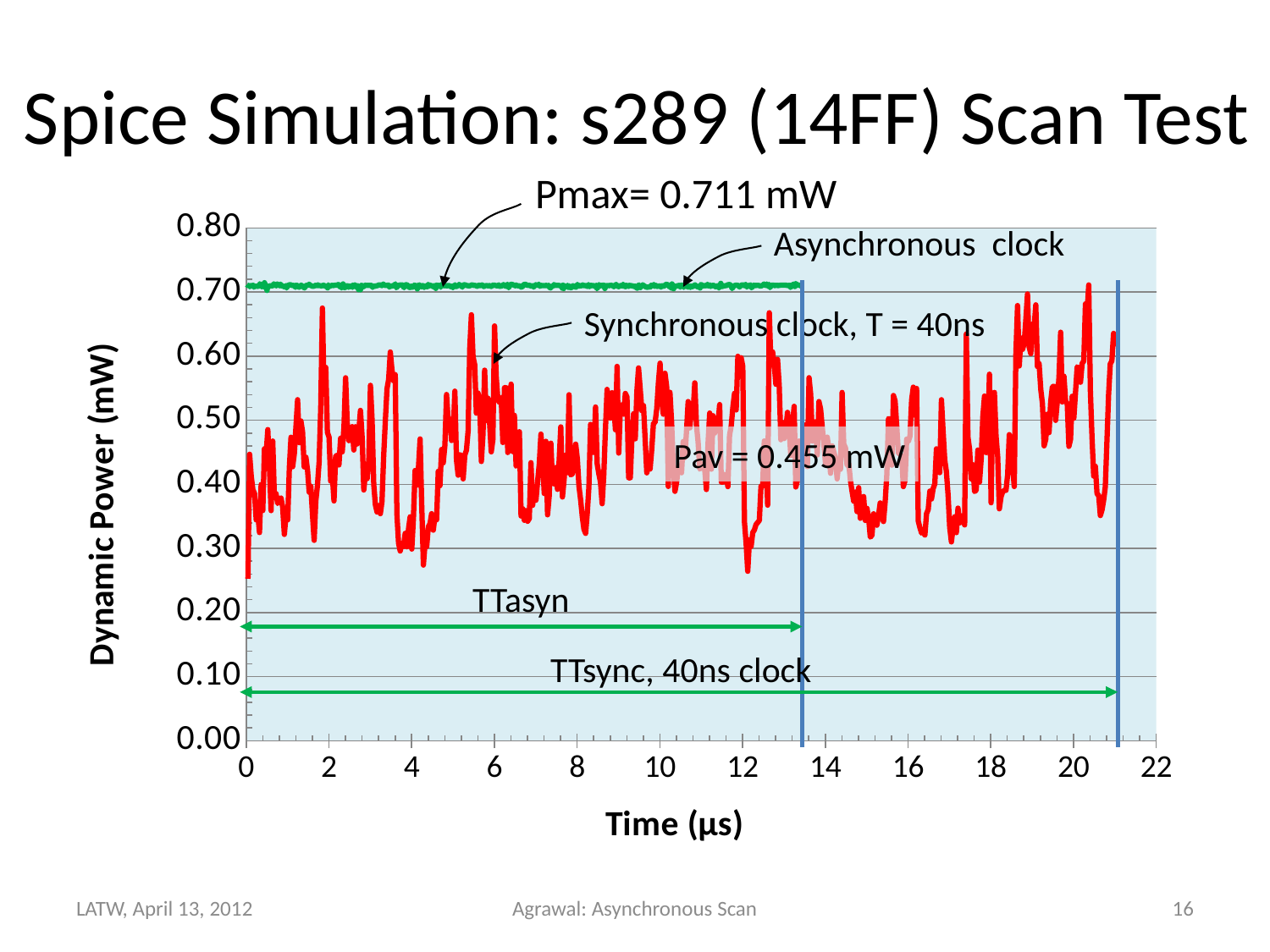
What kind of chart is shown on the slide? line chart What is the value of Pmax annotated on the chart? 0.711 mW Which series has the higher dynamic power, the asynchronous clock or the synchronous clock? Asynchronous clock Is the dynamic power of the synchronous clock at 15 µs greater or less than 0.50 mW? less What is the value of Pav annotated on the chart? 0.455 mW What clock period is given for the synchronous clock? T = 40ns What is the label of the x axis? Time (µs) Does the asynchronous clock line rise, fall, or stay flat across the time axis? stay flat Which test time is longer, TTasyn or TTsync? TTsync How many data series are plotted on the chart? 2 Is the dynamic power of the asynchronous clock greater or less than 0.60 mW? greater What is the difference between Pmax and Pav as annotated on the chart? 0.256 mW